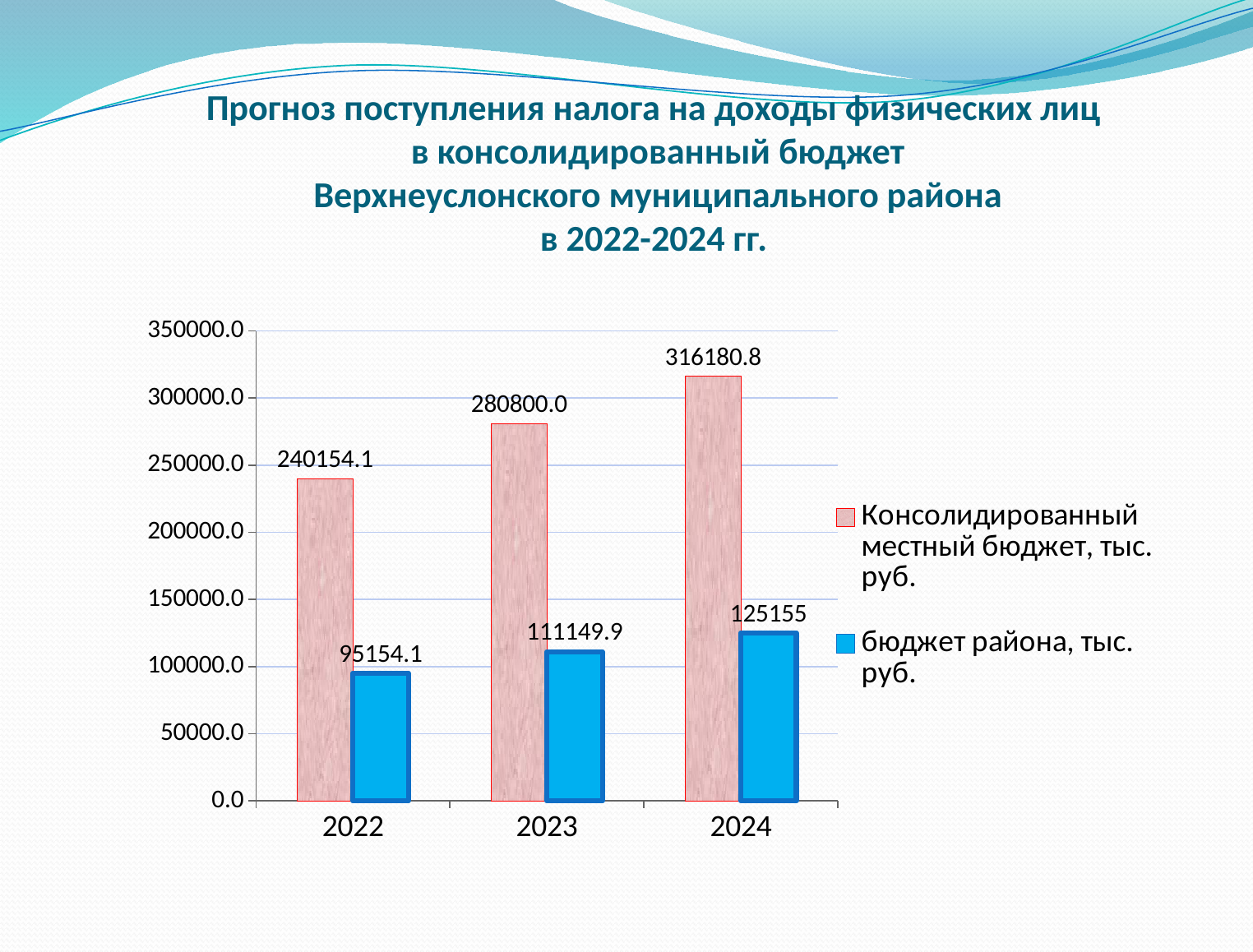
How many years are shown on the x axis? 3 What is the difference between the consolidated local budget and the district budget in 2022? 145000.0 Do the consolidated local budget values rise or fall from 2022 to 2024? rise Is the value for the district budget in 2024 greater or less than 150000.0? less How many series does the legend list? 2 Which is larger in 2023: the consolidated local budget or the district budget? Консолидированный местный бюджет What is the value of the district budget (бюджет района) for 2022? 95154.1 Which year has the highest value for the consolidated local budget? 2024 What is the difference between the consolidated local budget values for 2024 and 2023? 35380.8 Which year has the lowest value for the district budget? 2022 What is the value of the consolidated local budget (Консолидированный местный бюджет) for 2023? 280800.0 What is the value of the district budget (бюджет района) for 2024? 125155